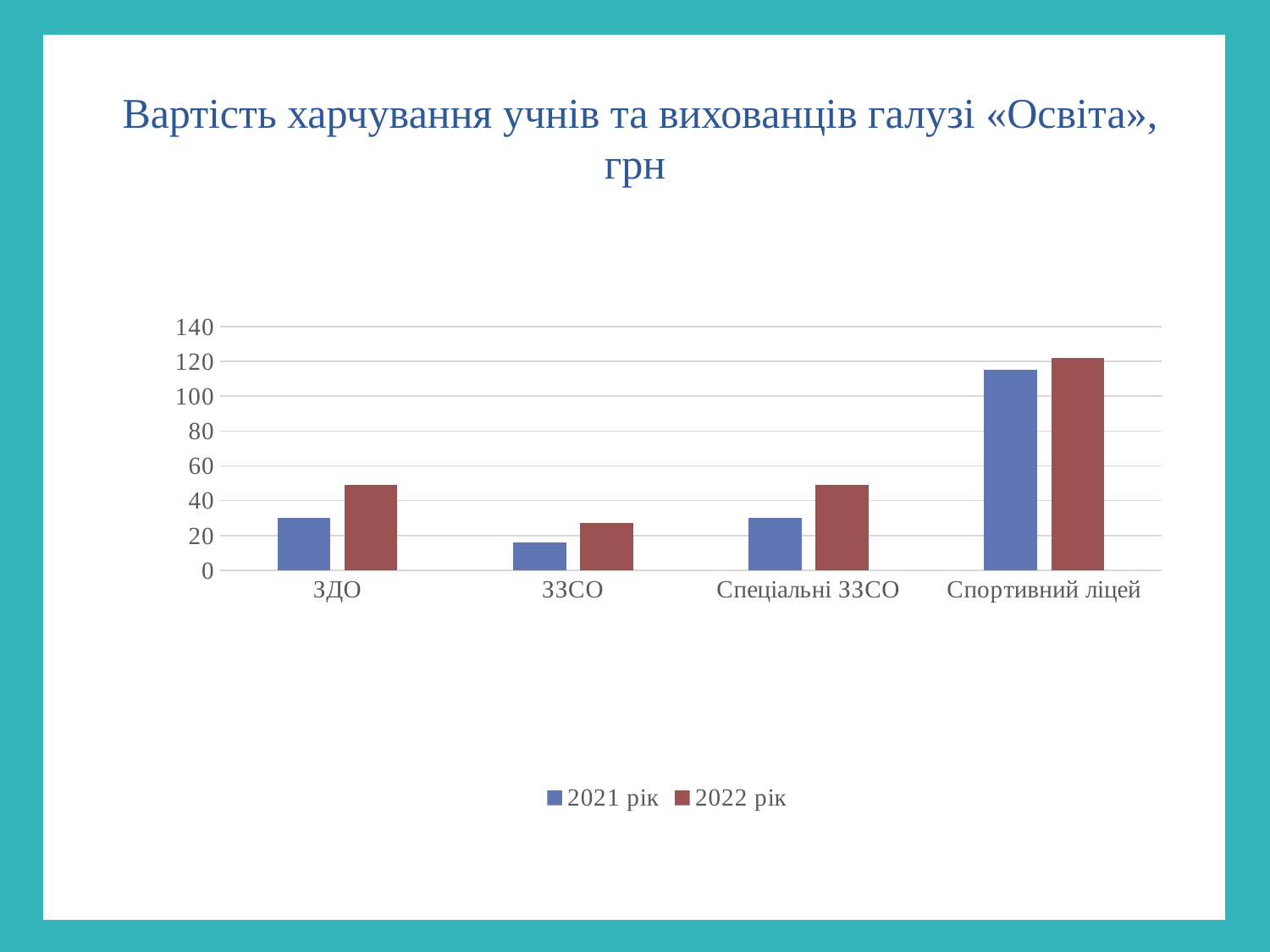
Is the 2021 рік value for ЗЗСО greater or less than 20? less Which category has the highest value for the 2021 рік series? Спортивний ліцей For ЗЗСО, which series has the larger value, 2021 рік or 2022 рік? 2022 рік Which category has the lowest value for the 2022 рік series? ЗЗСО What kind of chart is shown on the slide? bar chart Which category has the highest value for the 2022 рік series? Спортивний ліцей What is the title of the chart on the slide? Вартість харчування учнів та вихованців галузі «Освіта», грн How many series does the legend list? 2 Is the 2021 рік value for Спортивний ліцей greater or less than 100? greater Which category has the lowest value for the 2021 рік series? ЗЗСО For ЗДО, which series has the larger value, 2021 рік or 2022 рік? 2022 рік How many categories are shown on the x axis of the chart? 4